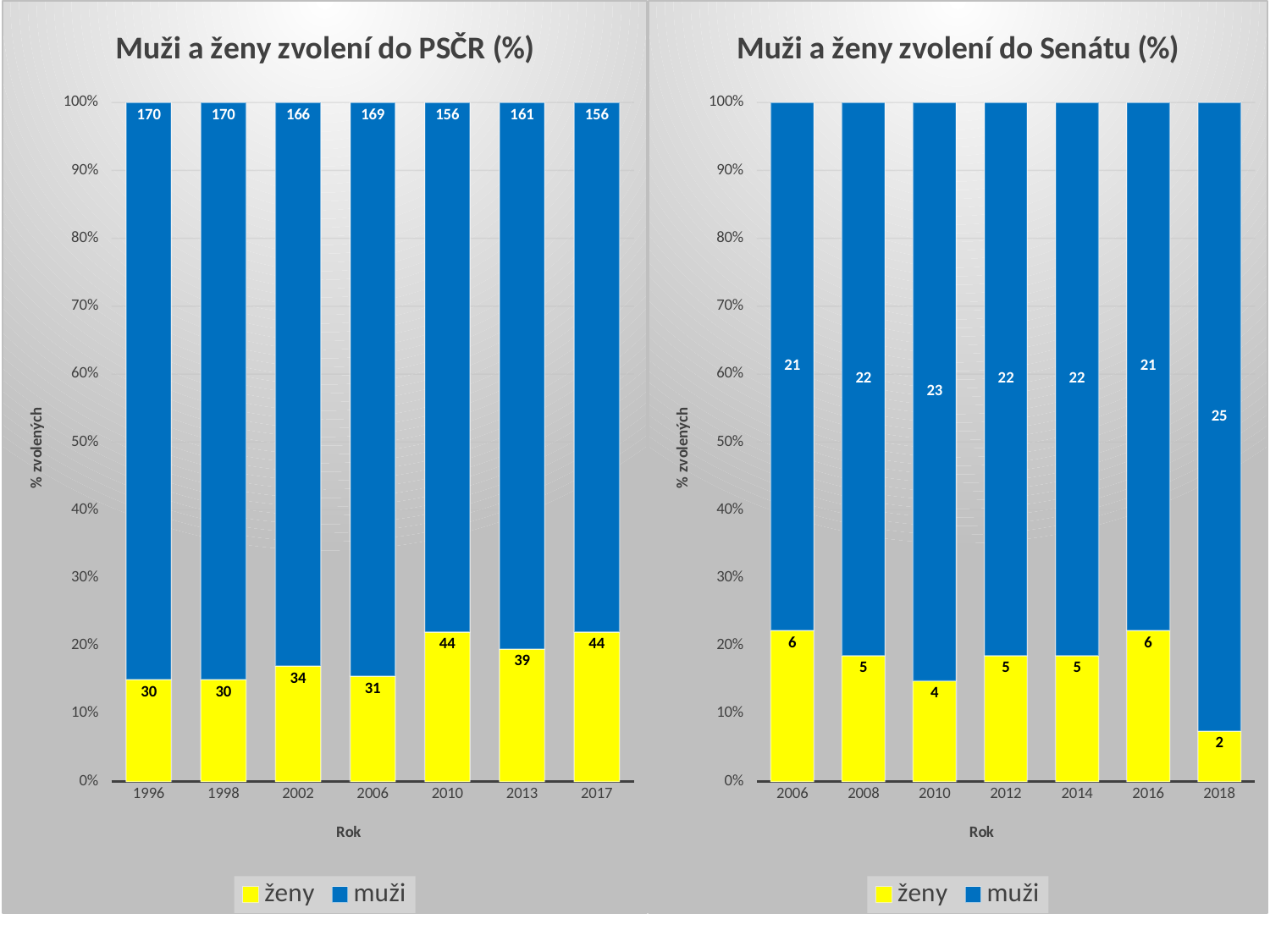
In the chart 'Muži a ženy zvolení do PSČR (%)', what is the sum of the ženy and muži labels for 2006? 200 What type of chart is 'Muži a ženy zvolení do Senátu (%)'? stacked bar chart In the chart 'Muži a ženy zvolení do PSČR (%)', is the ženy label larger in 2013 or in 2017? 2017 In the chart 'Muži a ženy zvolení do Senátu (%)', is the share of ženy in 2018 greater or less than 10%? less How many years are shown on the x axis of the chart 'Muži a ženy zvolení do Senátu (%)'? 7 In the chart 'Muži a ženy zvolení do PSČR (%)', what is the data label for muži in 2002? 166 How many series does the legend of the chart 'Muži a ženy zvolení do PSČR (%)' list? 2 In the chart 'Muži a ženy zvolení do Senátu (%)', which year has the lowest data label for ženy? 2018 In the chart 'Muži a ženy zvolení do PSČR (%)', what is the difference between the muži labels for 1996 and 2017? 14 In the chart 'Muži a ženy zvolení do Senátu (%)', what is the data label for muži in 2018? 25 In the chart 'Muži a ženy zvolení do PSČR (%)', what is the data label for ženy in 2010? 44 In the chart 'Muži a ženy zvolení do Senátu (%)', what is the data label for ženy in 2010? 4